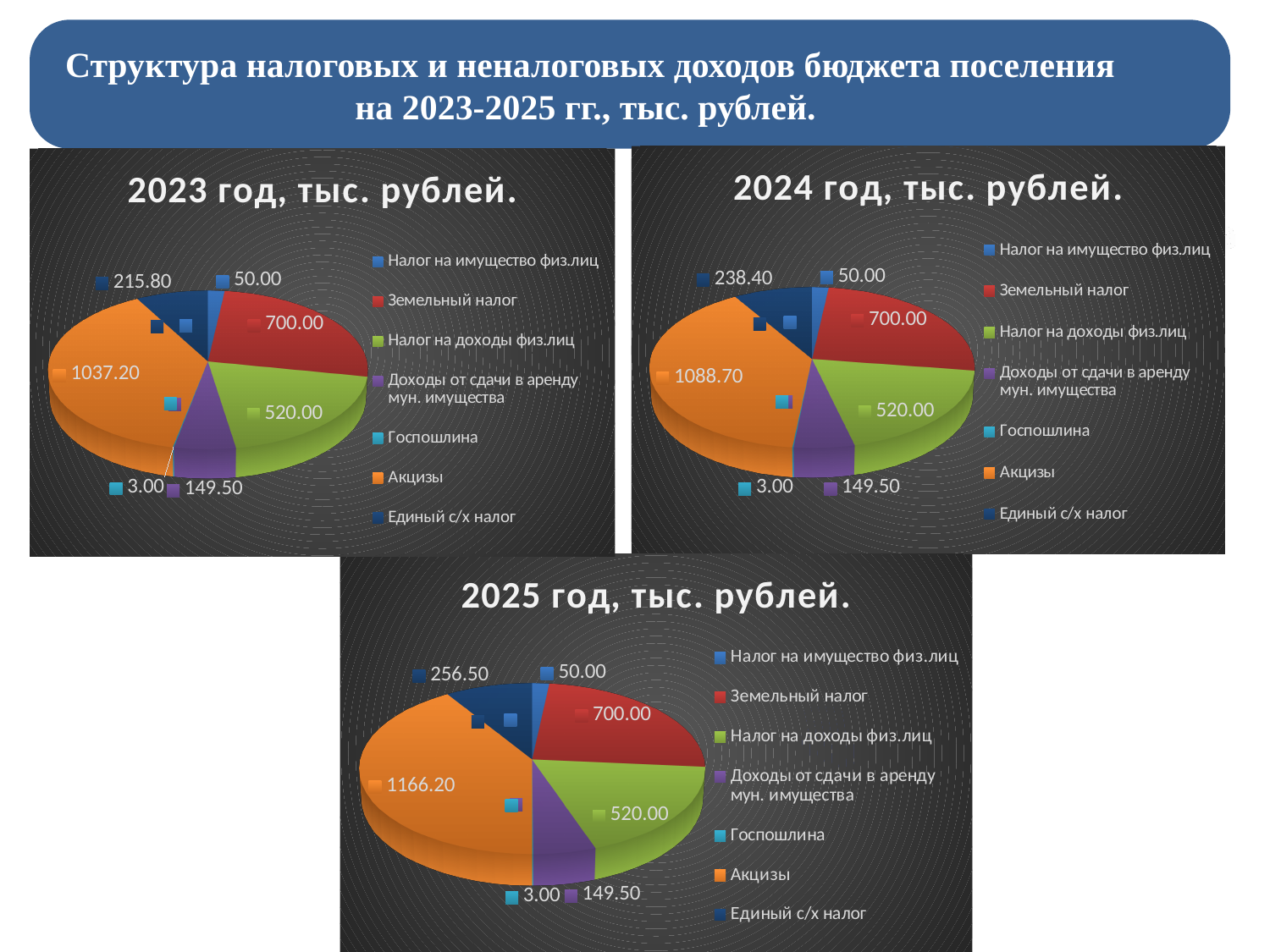
How many charts are shown on the slide? 3 In the chart titled "2023 год, тыс. рублей.", what is the value for Акцизы? 1037.20 In the chart titled "2024 год, тыс. рублей.", which is larger: Налог на доходы физ.лиц or Единый с/х налог? Налог на доходы физ.лиц In the chart titled "2025 год, тыс. рублей.", what is the value for Земельный налог? 700.00 In the chart titled "2024 год, тыс. рублей.", what is the value for Единый с/х налог? 238.40 What type of chart is the chart titled "2025 год, тыс. рублей."? Pie chart In the chart titled "2023 год, тыс. рублей.", which category has the largest value? Акцизы In the chart titled "2025 год, тыс. рублей.", what is the difference between Акцизы and Земельный налог? 466.20 In the chart titled "2023 год, тыс. рублей.", what colour is the slice for Акцизы? Orange In the chart titled "2024 год, тыс. рублей.", which category has the smallest value? Госпошлина How many categories does the legend of the chart titled "2023 год, тыс. рублей." list? 7 In the chart titled "2025 год, тыс. рублей.", what is the value for Акцизы? 1166.20